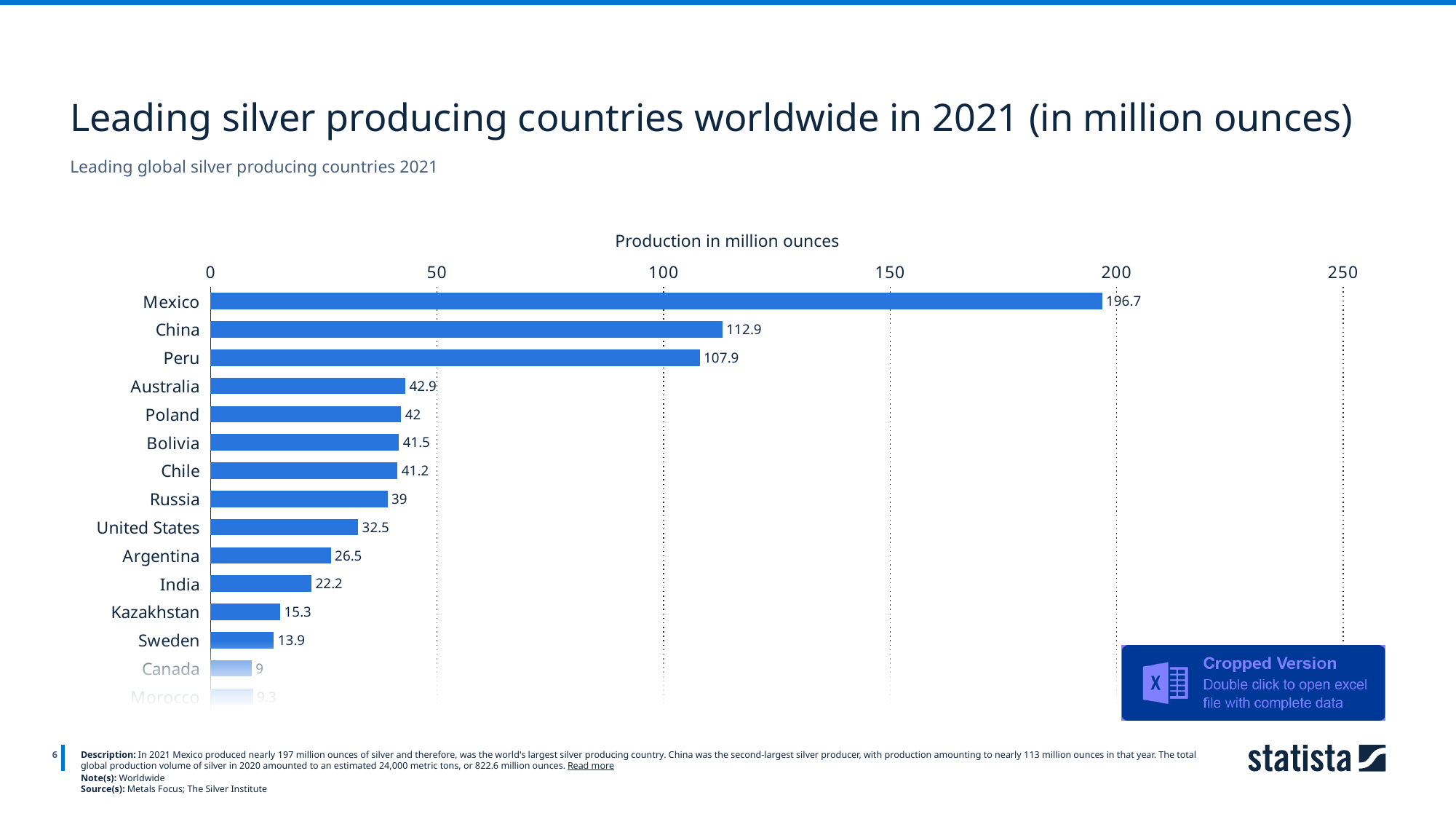
Which has a larger value, Argentina or India? Argentina What was Mexico's silver production in 2021 according to the chart? 196.7 Which country has the highest silver production in the chart? Mexico What value is shown for Kazakhstan? 15.3 What value is shown for China? 112.9 What value is shown for the United States? 32.5 What is the difference between Australia's and Russia's values? 3.9 Is the value for Peru greater or less than 100? greater What is the difference between Mexico's and China's values? 83.8 What kind of chart is shown on the slide? Bar chart What is the axis title shown above the chart? Production in million ounces What value is shown for Peru? 107.9